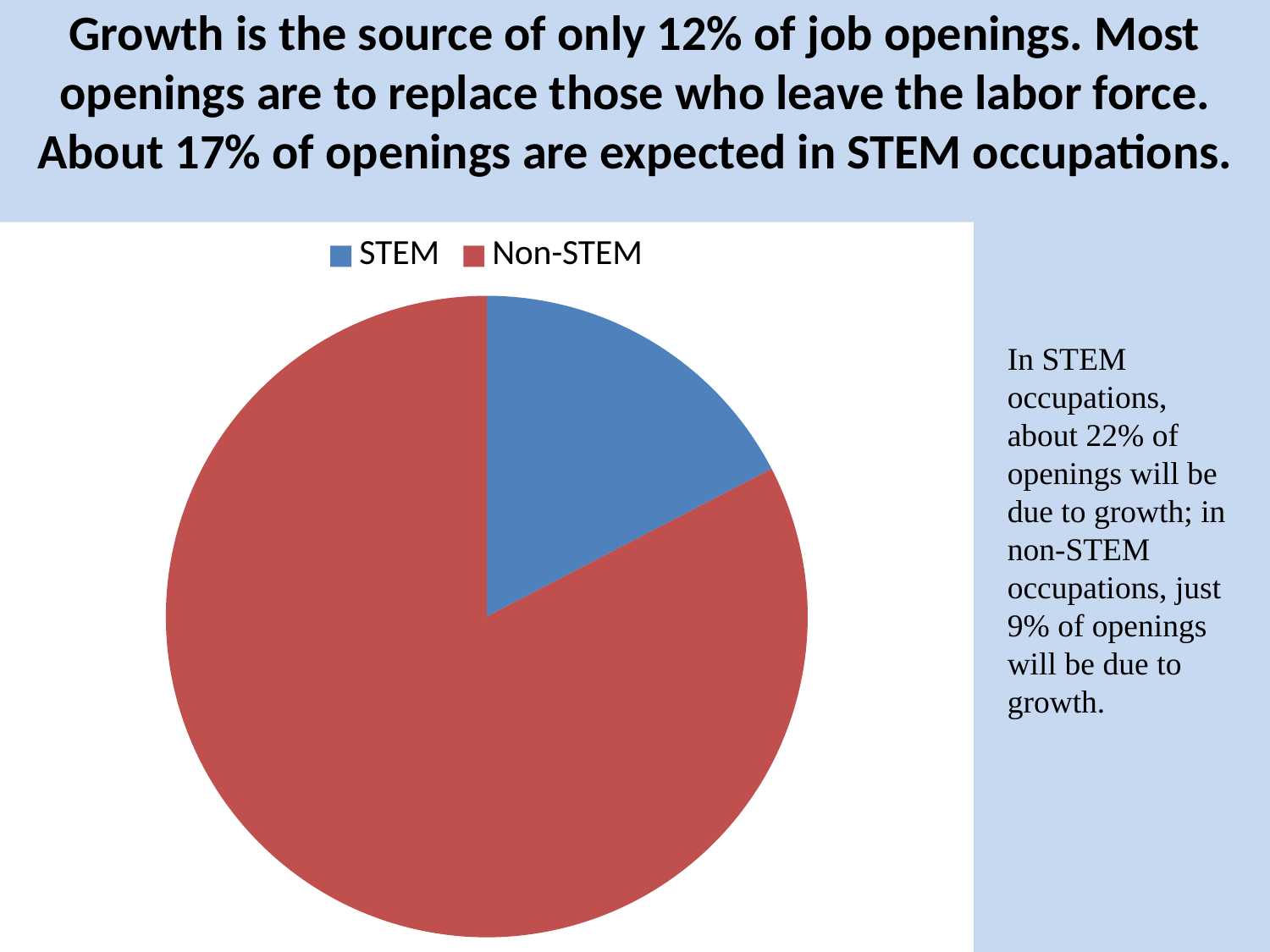
Does the STEM slice take up more or less than a quarter of the pie chart? less Which slice of the pie chart is larger, STEM or Non-STEM? Non-STEM What kind of chart is shown on the slide? Pie chart How many slices does the pie chart have? 2 Which category has the smallest slice in the pie chart? STEM What are the two categories listed in the pie chart's legend? STEM and Non-STEM Does the Non-STEM slice take up more or less than half of the pie chart? more How many entries does the legend of the pie chart list? 2 What colour is the STEM slice in the pie chart? Blue Which category has the largest slice in the pie chart? Non-STEM